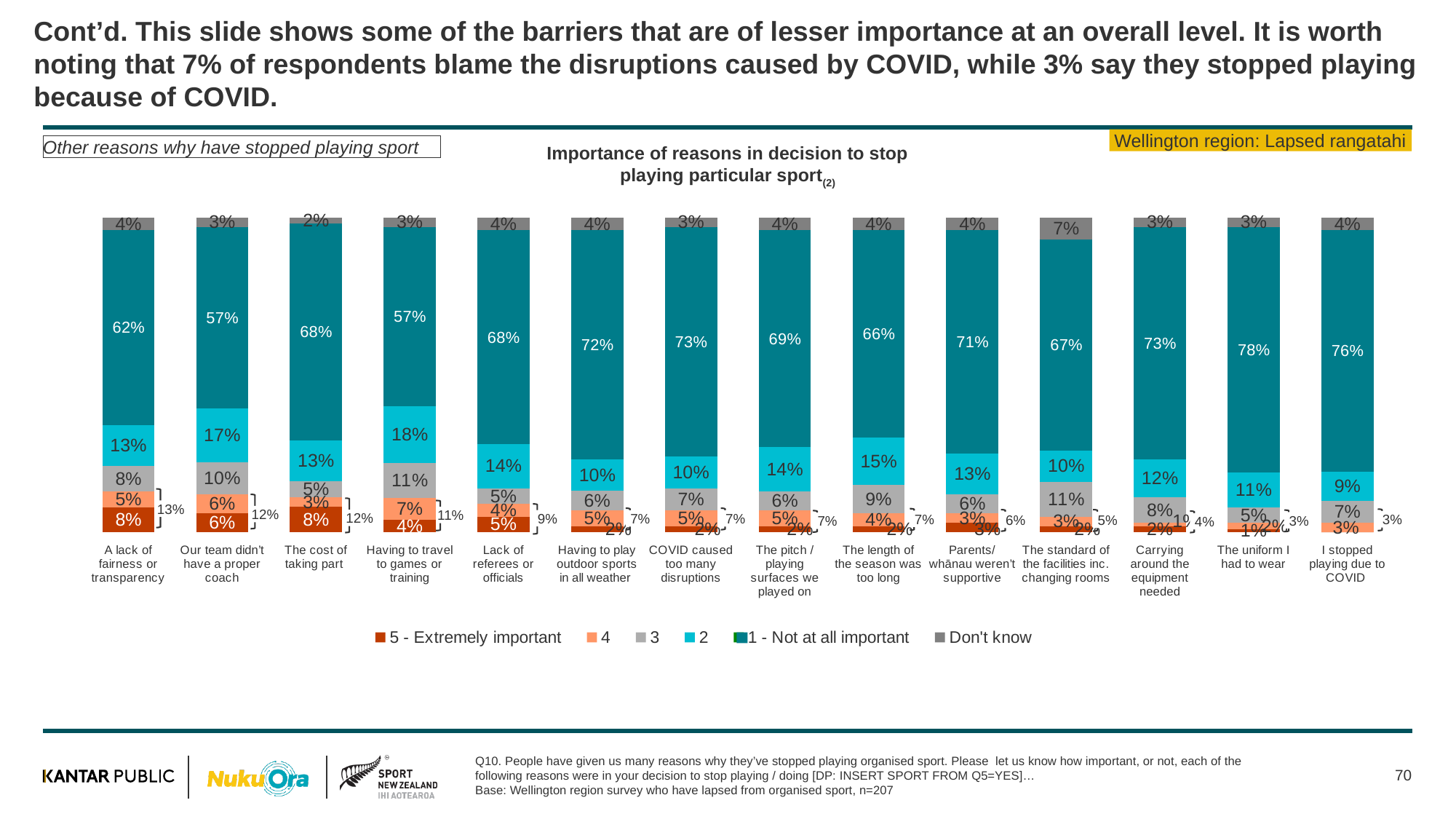
What is the title of the chart? Importance of reasons in decision to stop playing particular sport What percentage rated 'COVID caused too many disruptions' as '1 - Not at all important'? 73% How many reasons (categories) are shown along the x axis? 14 Which has a larger '2' share: 'The length of the season was too long' or 'Having to play outdoor sports in all weather'? The length of the season was too long What kind of chart is shown on the slide? Stacked bar chart What is the difference between the '1 - Not at all important' share for 'I stopped playing due to COVID' (76%) and for 'Our team didn't have a proper coach' (57%)? 19 percentage points How many series does the legend list? 6 What percentage rated 'Having to travel to games or training' as '2'? 18% Which reason has the highest 'Don't know' share? The standard of the facilities inc. changing rooms Which reason has the highest share of '1 - Not at all important' responses? The uniform I had to wear What percentage rated 'The uniform I had to wear' as '1 - Not at all important'? 78% What percentage rated 'A lack of fairness or transparency' as '5 - Extremely important'? 8%